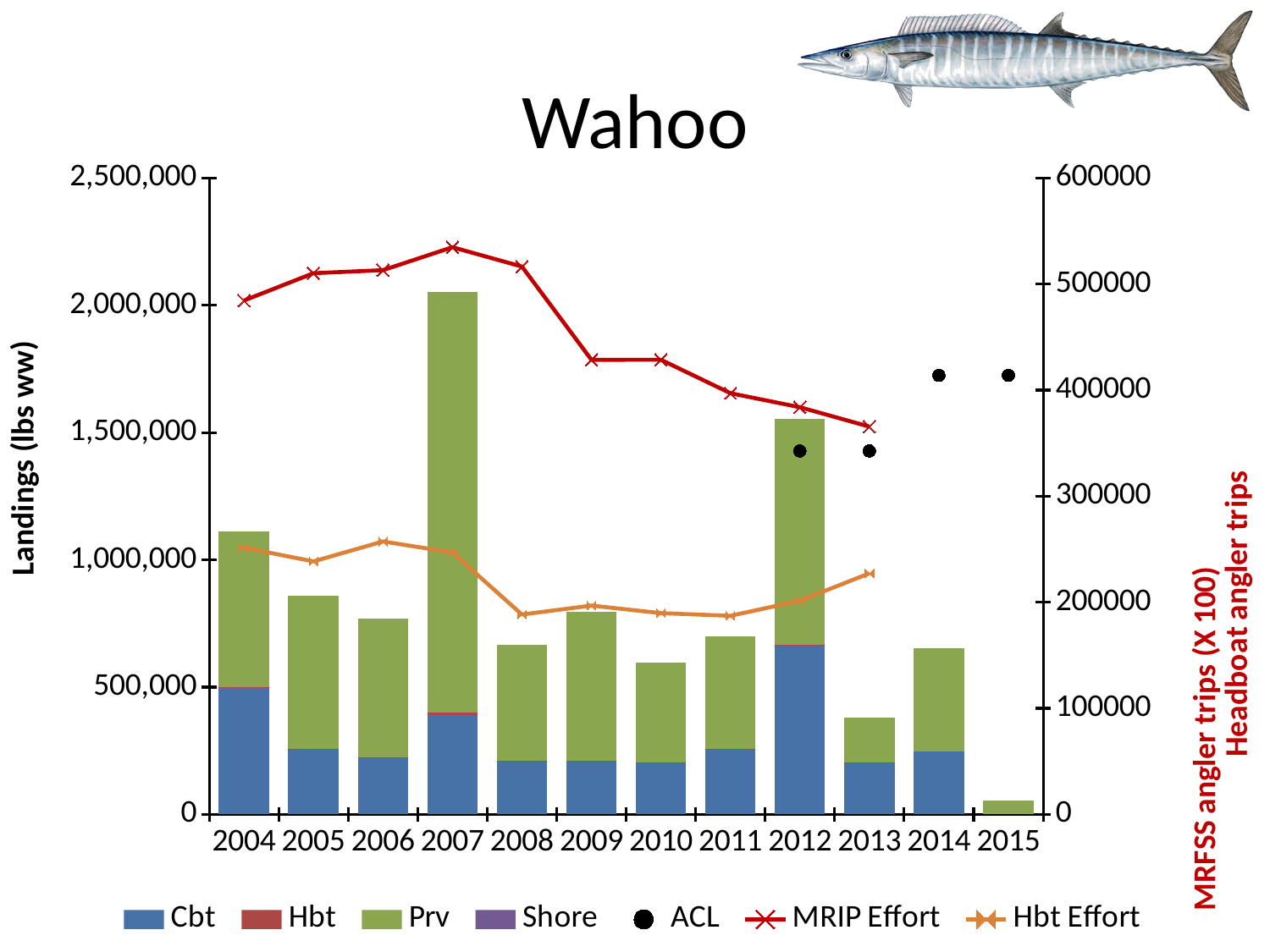
Which year has the tallest stacked landings bar? 2007 Which year has the larger Cbt (blue) segment, 2011 or 2012? 2012 Which year has the shortest stacked landings bar? 2015 Is the total landings bar for 2007 greater or less than 2,000,000? greater Is the MRIP Effort value for 2007 greater or less than 500000? greater What is the title of the chart? Wahoo How many entries does the legend list? 7 Does the MRIP Effort line rise or fall from 2007 to 2013? fall Is the total landings bar for 2013 greater or less than 500,000? less How many years are shown on the x axis? 12 Which year has the larger total landings bar, 2004 or 2005? 2004 In which year does the MRIP Effort line reach its highest point? 2007